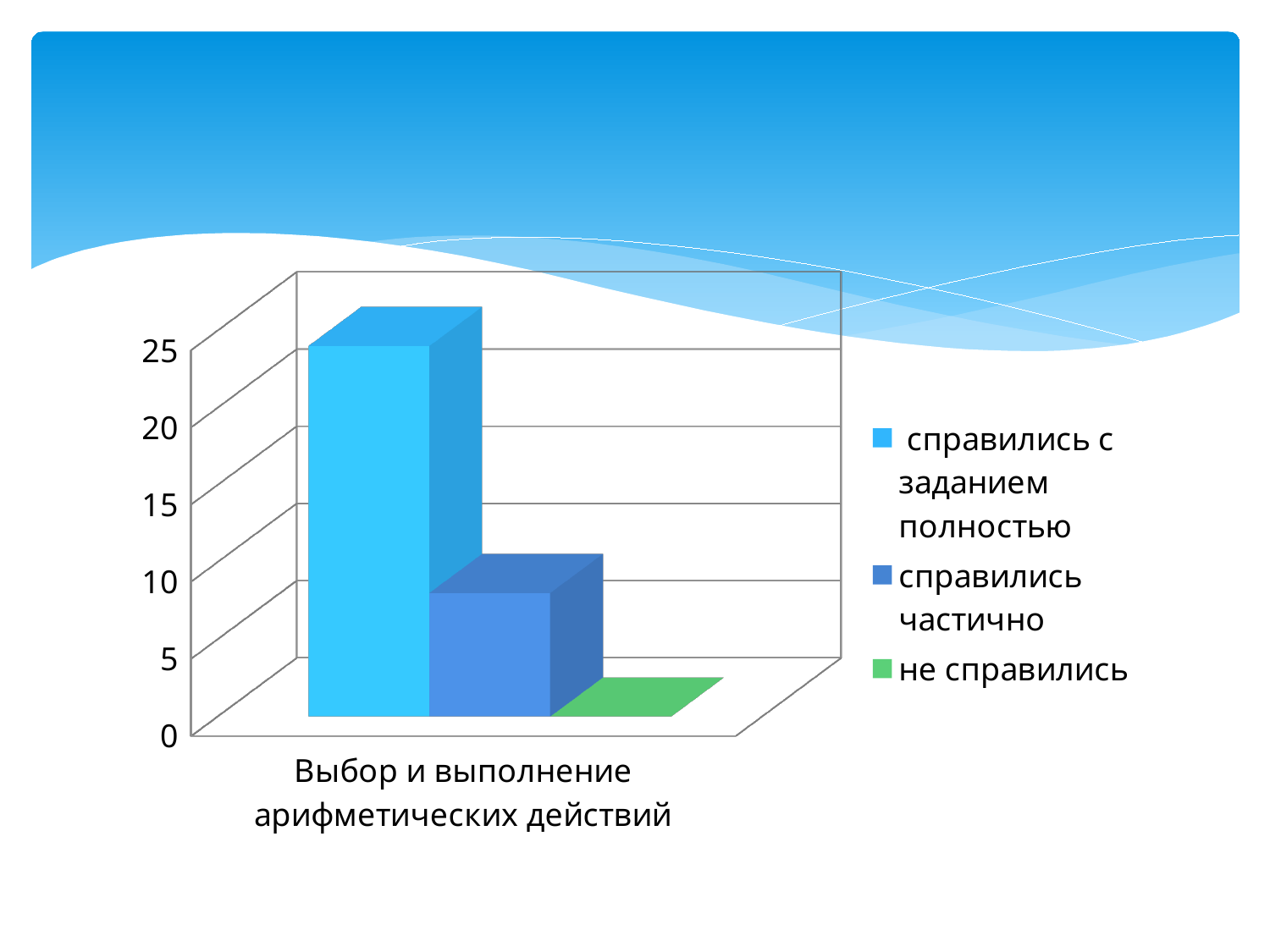
Is the value for "справились частично" greater or less than 15? less What kind of chart is shown on the slide? bar chart What colour represents the series "не справились" in the legend? green Which series has the highest value for "Выбор и выполнение арифметических действий"? справились с заданием полностью What is the value for "не справились"? 0 Is the value for "справились частично" greater or less than 5? greater Which series has the lowest value for "Выбор и выполнение арифметических действий"? не справились How many series does the legend list? 3 Which is larger: the value for "справились с заданием полностью" or the value for "справились частично"? справились с заданием полностью Is the value for "справились с заданием полностью" greater or less than 20? greater How many categories are shown on the x axis? 1 What is the label of the category on the x axis? Выбор и выполнение арифметических действий